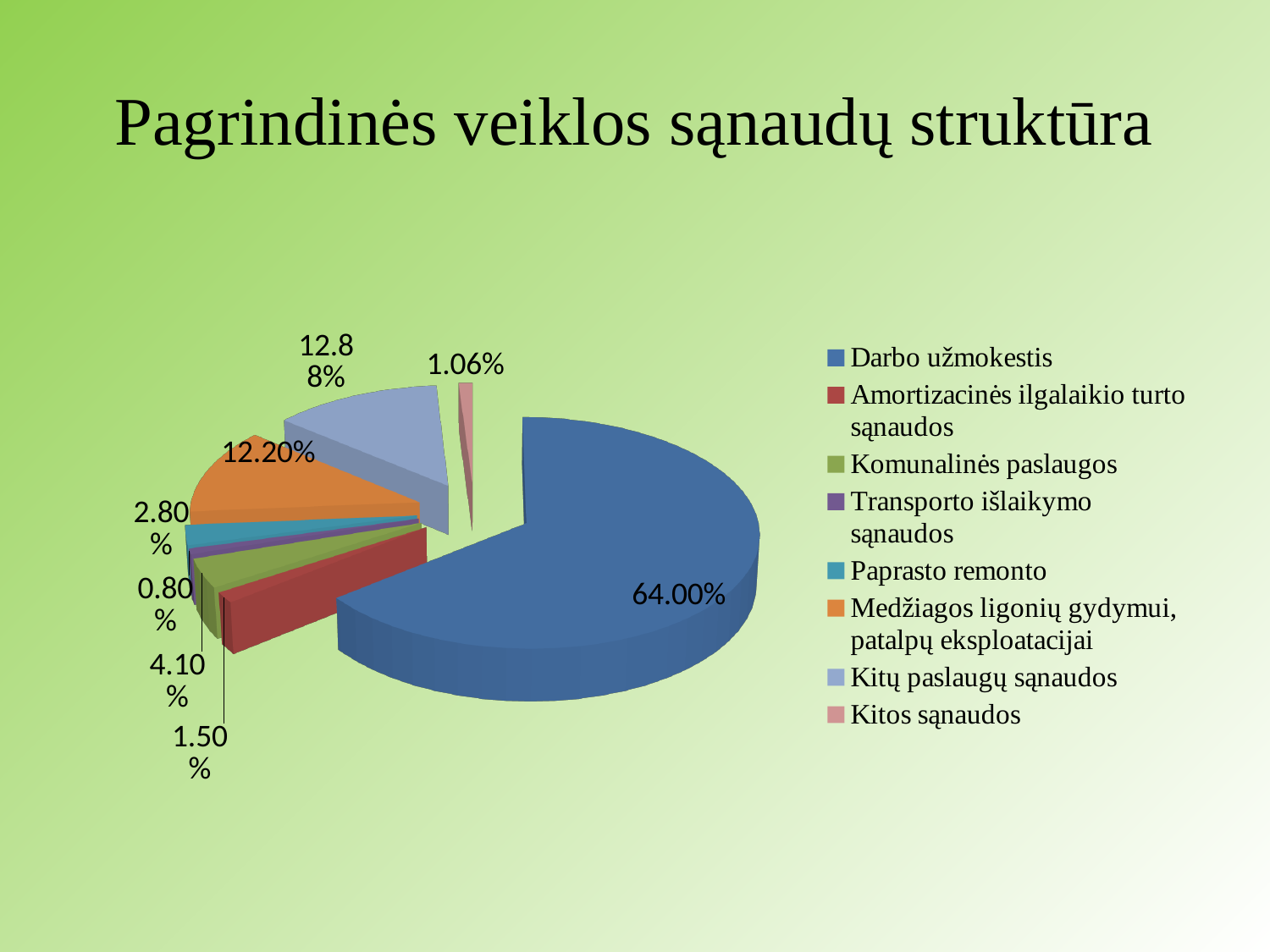
What type of chart is shown on the slide? pie chart What is the value shown for Kitų paslaugų sąnaudos? 12.88% What is the value shown for Kitos sąnaudos? 1.06% How many categories does the legend list? 8 Which category has the smallest share of the pie? Transporto išlaikymo sąnaudos What is the value shown for Komunalinės paslaugos? 4.10% Which category has the largest share of the pie? Darbo užmokestis What is the value shown for Medžiagos ligonių gydymui, patalpų eksploatacijai? 12.20% What is the difference between the shares of Darbo užmokestis and Medžiagos ligonių gydymui, patalpų eksploatacijai? 51.80% Which is larger, the share for Paprasto remonto or the share for Amortizacinės ilgalaikio turto sąnaudos? Paprasto remonto What is the title of the chart on the slide? Pagrindinės veiklos sąnaudų struktūra What share of the pie does Darbo užmokestis represent? 64.00%